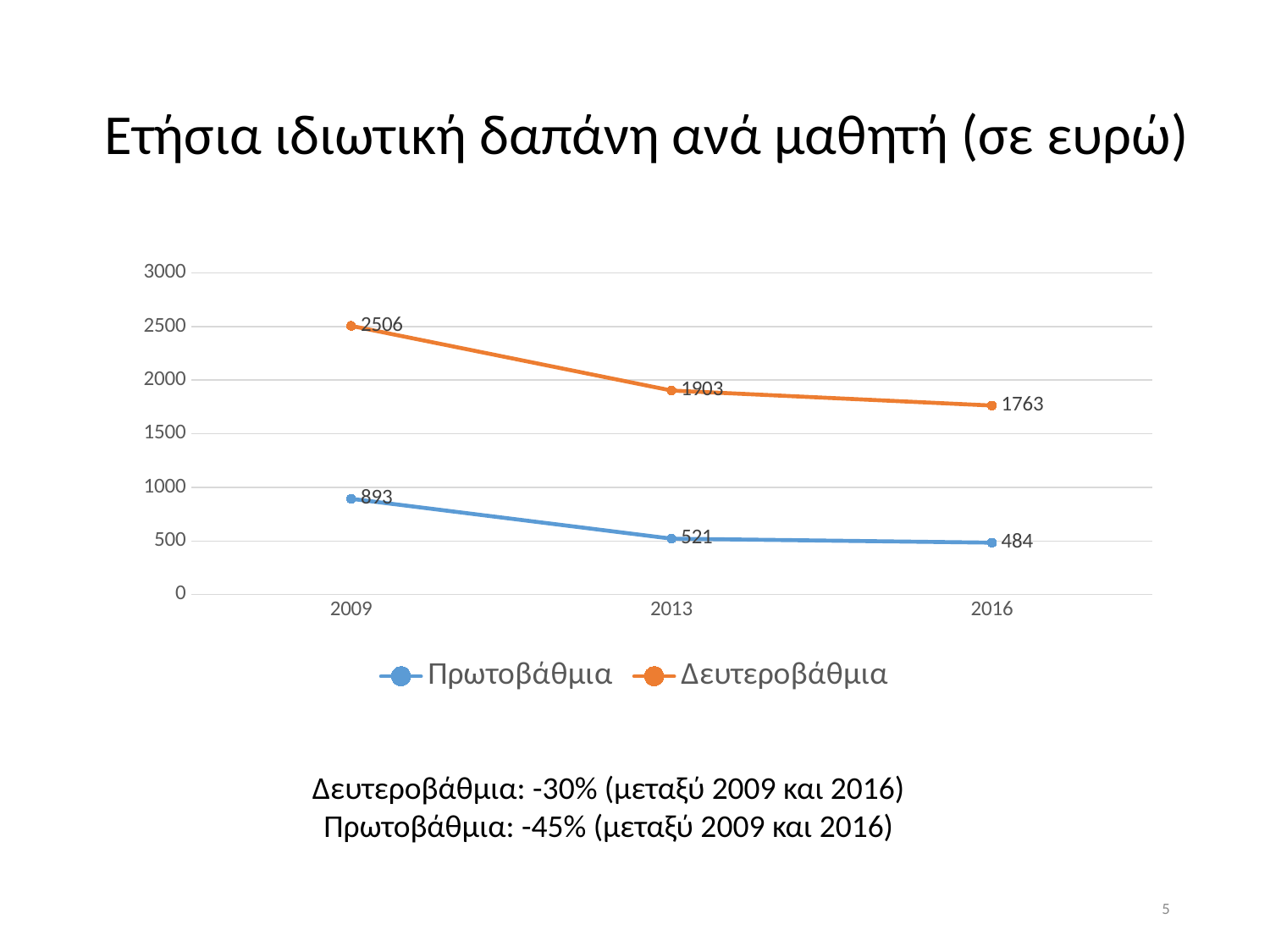
What is the value for Δευτεροβάθμια in 2016? 1763 What is the difference between the Δευτεροβάθμια and Πρωτοβάθμια values in 2013? 1382 How many years are shown on the x axis? 3 How many series does the legend list? 2 What is the value for Δευτεροβάθμια in 2009? 2506 What is the value for Πρωτοβάθμια in 2016? 484 Which series has the larger value in 2016, Πρωτοβάθμια or Δευτεροβάθμια? Δευτεροβάθμια Do the values for Πρωτοβάθμια rise or fall from 2009 to 2016? fall What is the difference between the Δευτεροβάθμια values in 2009 and 2016? 743 In which year is the value for Πρωτοβάθμια lowest? 2016 In which year is the value for Δευτεροβάθμια highest? 2009 What is the value for Πρωτοβάθμια in 2013? 521